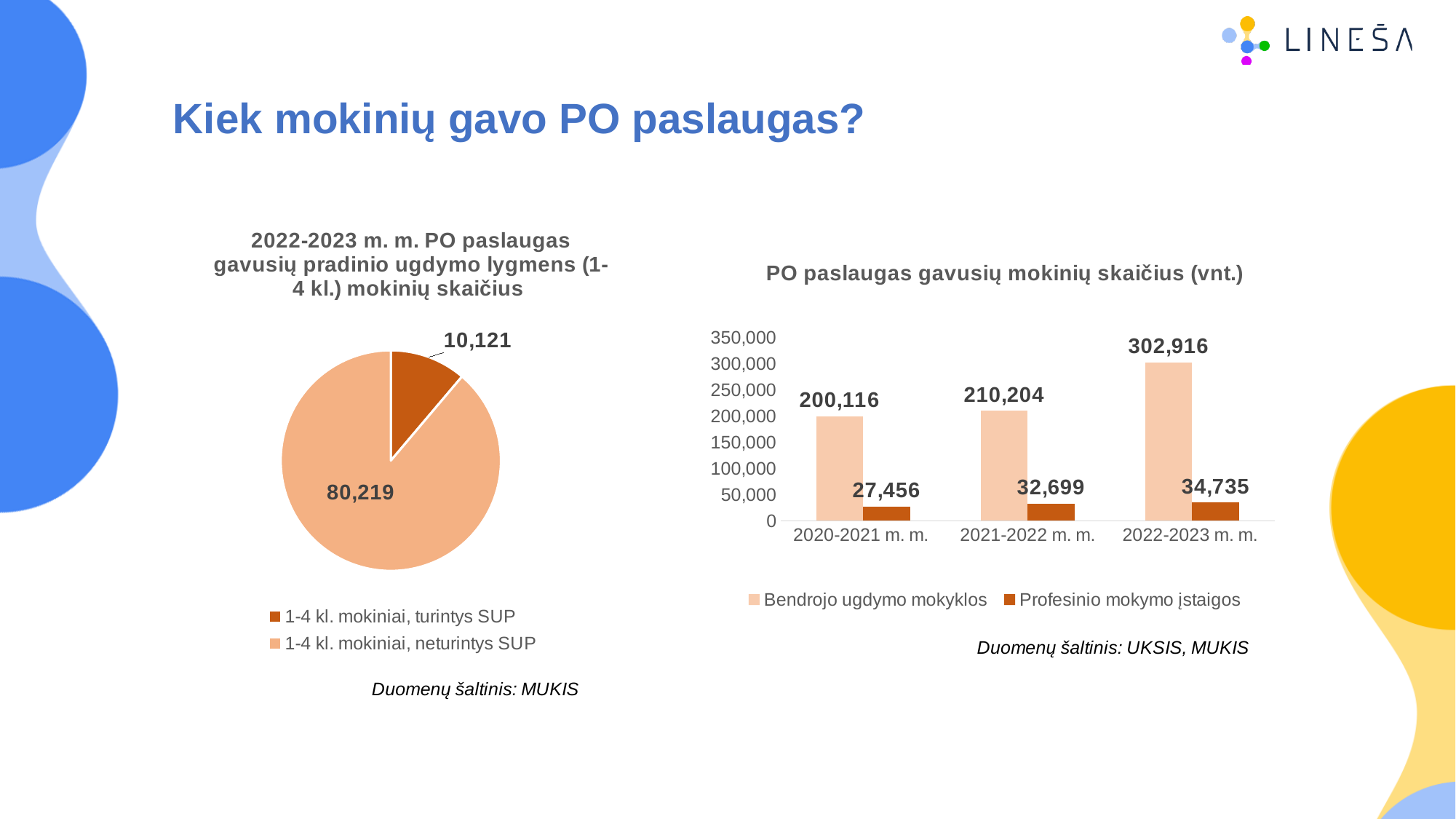
In the chart 'PO paslaugas gavusių mokinių skaičius (vnt.)', what is the value for 'Profesinio mokymo įstaigos' in 2020-2021 m. m.? 27,456 What kind of chart is the chart on the right, 'PO paslaugas gavusių mokinių skaičius (vnt.)'? bar chart In the pie chart on the left, what is the value for '1-4 kl. mokiniai, turintys SUP'? 10,121 How many series does the legend of the chart 'PO paslaugas gavusių mokinių skaičius (vnt.)' list? 2 In the pie chart on the left, what is the value for '1-4 kl. mokiniai, neturintys SUP'? 80,219 In the chart 'PO paslaugas gavusių mokinių skaičius (vnt.)', do the 'Bendrojo ugdymo mokyklos' values rise or fall from 2020-2021 m. m. to 2022-2023 m. m.? rise In the pie chart on the left, what is the total of the two slices? 90,340 In the pie chart on the left, which slice is larger: '1-4 kl. mokiniai, turintys SUP' or '1-4 kl. mokiniai, neturintys SUP'? 1-4 kl. mokiniai, neturintys SUP In the chart 'PO paslaugas gavusių mokinių skaičius (vnt.)', which school year has the lowest value for 'Profesinio mokymo įstaigos'? 2020-2021 m. m. In the chart 'PO paslaugas gavusių mokinių skaičius (vnt.)', what is the difference between the 'Bendrojo ugdymo mokyklos' values for 2022-2023 m. m. and 2021-2022 m. m.? 92,712 In the chart 'PO paslaugas gavusių mokinių skaičius (vnt.)', what is the value for 'Bendrojo ugdymo mokyklos' in 2022-2023 m. m.? 302,916 In the chart 'PO paslaugas gavusių mokinių skaičius (vnt.)', which school year has the highest value for 'Bendrojo ugdymo mokyklos'? 2022-2023 m. m.